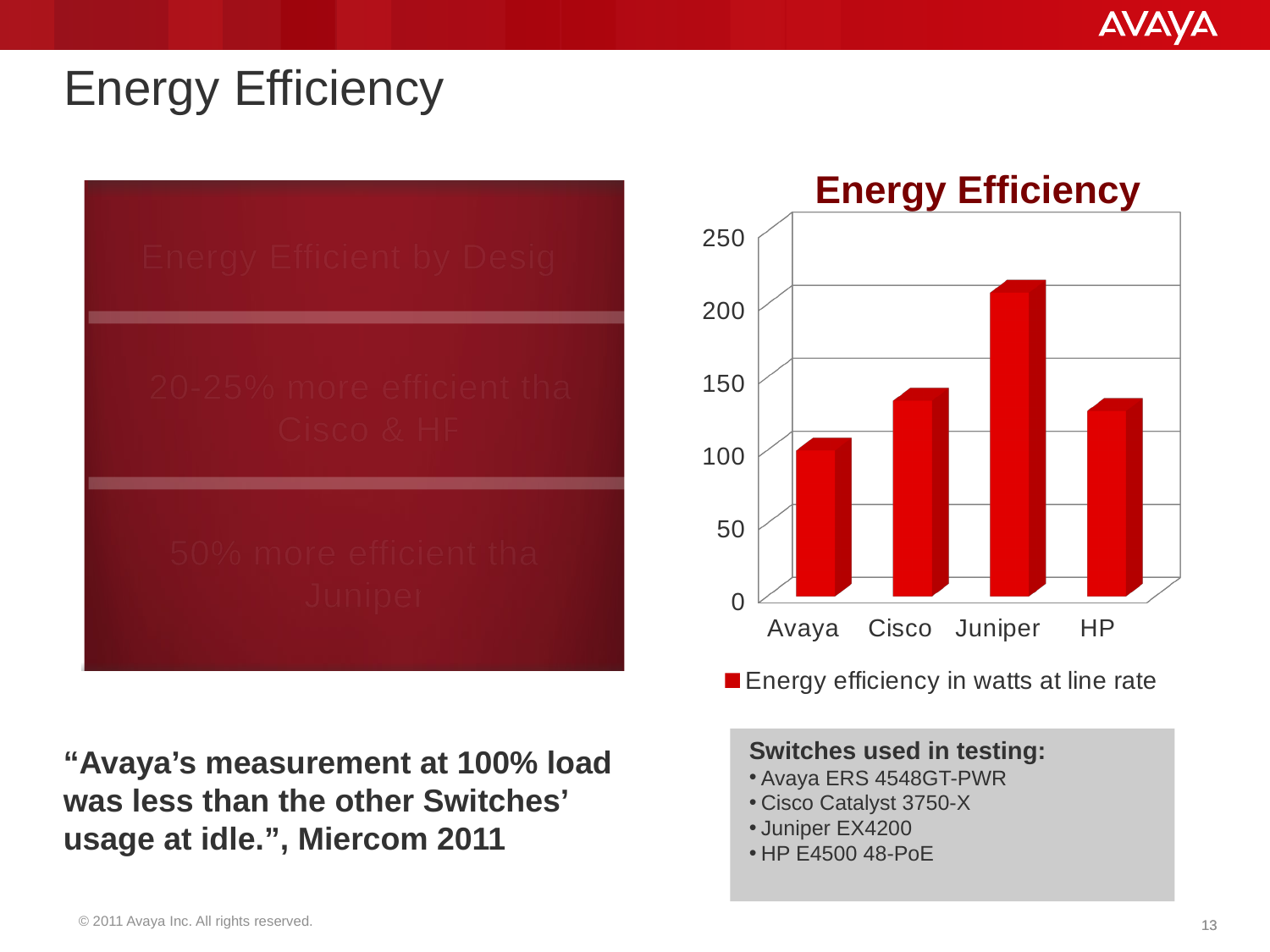
Is the value for HP greater or less than 100? greater Which category has the highest value in the Energy Efficiency chart? Juniper What kind of chart is shown on the slide? bar chart Which is larger in the Energy Efficiency chart, the value for Avaya or the value for HP? HP Is the value for Juniper greater or less than 200? greater How many categories are plotted in the Energy Efficiency chart? 4 Which category has the lowest value in the Energy Efficiency chart? Avaya How many series does the legend of the Energy Efficiency chart list? 1 Which is larger in the Energy Efficiency chart, the value for Juniper or the value for Cisco? Juniper Is the value for Avaya greater or less than 150? less What is the legend entry of the Energy Efficiency chart? Energy efficiency in watts at line rate